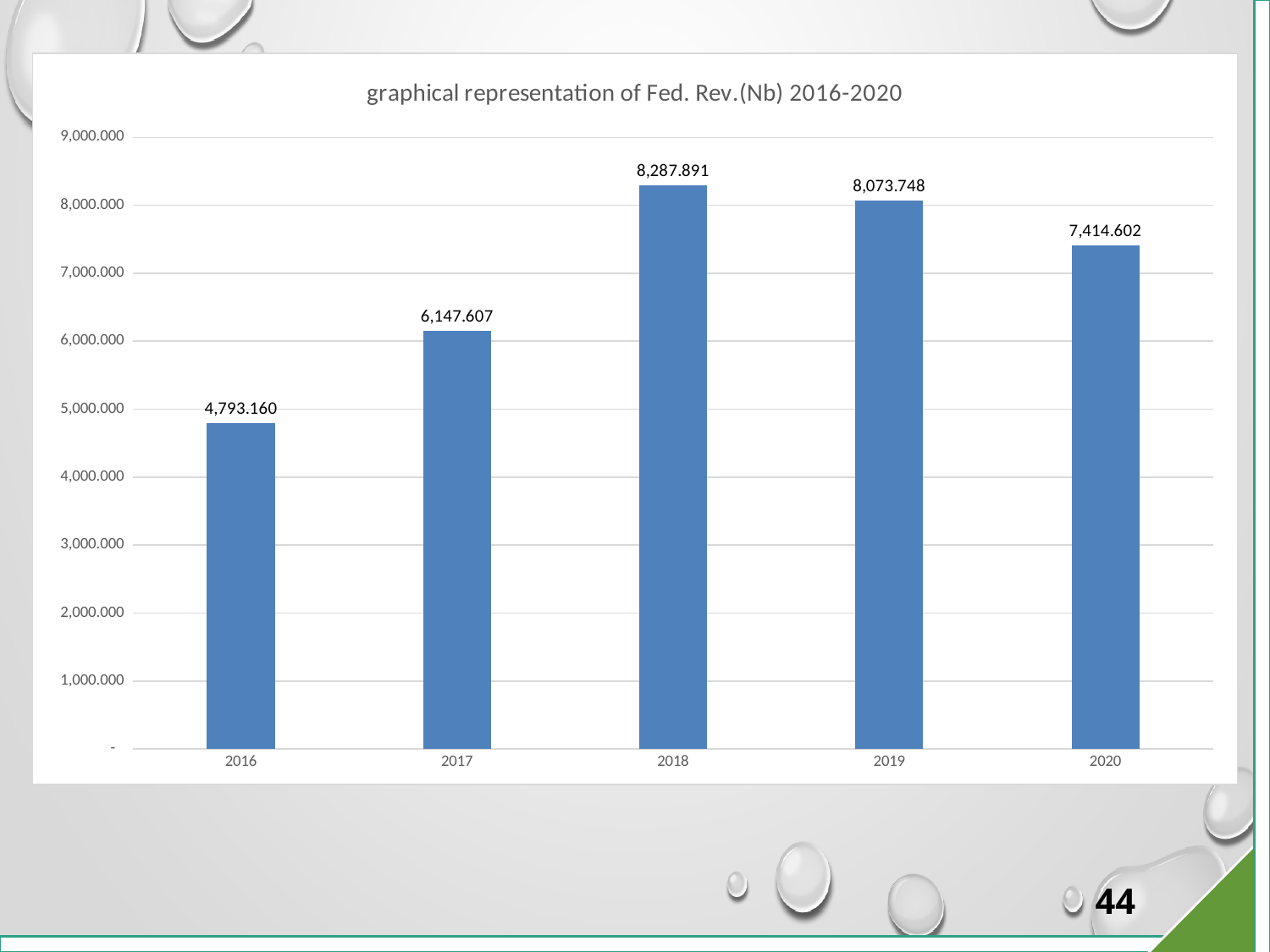
What is the value for 2020? 7,414.602 What is the value for 2018? 8,287.891 What kind of chart is shown? bar chart What is the value for 2016? 4,793.160 Do the values rise or fall from 2018 to 2020? fall What is the difference between the values for 2018 and 2019? 214.143 Which is larger, the value for 2019 or the value for 2020? 2019 Which year has the highest value? 2018 Is the value for 2016 greater or less than 5,000.000? less What is the difference between the values for 2017 and 2016? 1,354.447 Which year has the lowest value? 2016 How many years are shown on the x axis? 5